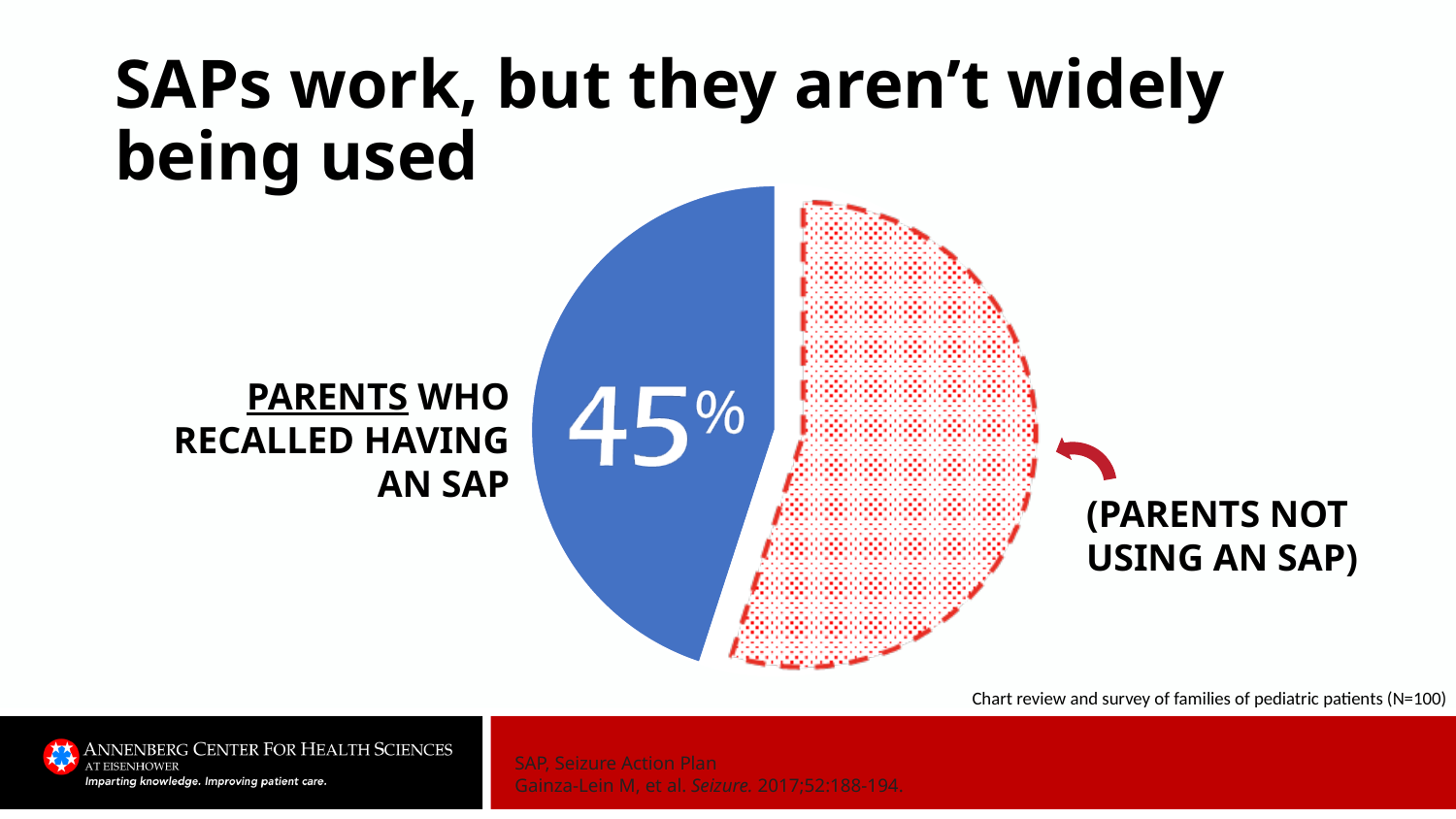
What is the sample size (N) noted below the chart? N=100 Is the share of parents who recalled having an SAP greater or less than 50%? less What percentage of parents recalled having an SAP? 45% Which slice is larger: parents who recalled having an SAP or parents not using an SAP? parents not using an SAP How many slices does the pie chart have? 2 What kind of chart is shown on the slide? pie chart What colour is the slice for parents who recalled having an SAP? blue Which group represents the smaller slice of the pie? parents who recalled having an SAP